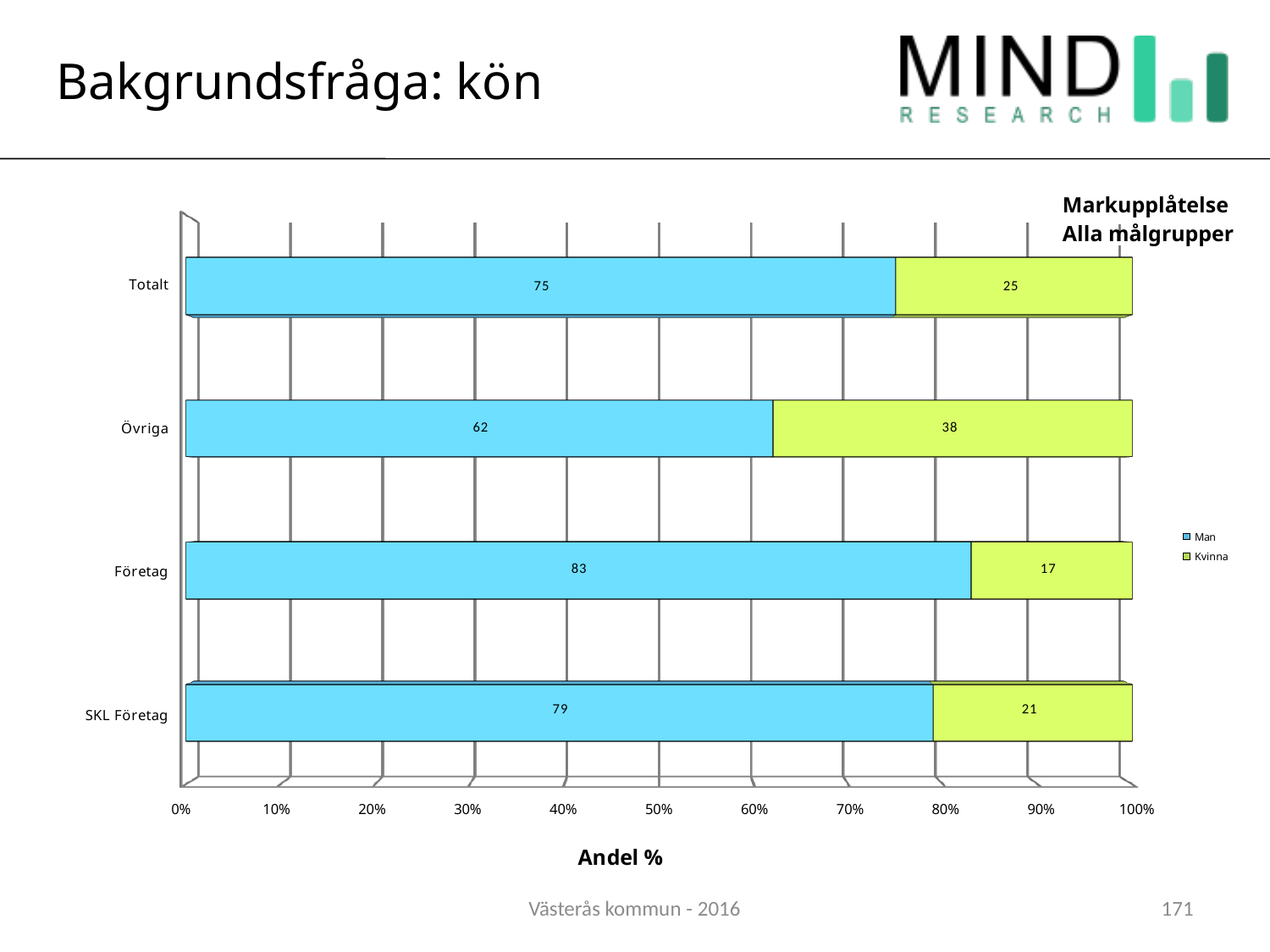
How many categories are shown on the chart? 4 What kind of chart is shown on the slide? Stacked bar chart How many series does the legend list? 2 What is the value for Kvinna in the Övriga category? 38 Is the Man value for SKL Företag larger than the Man value for Totalt? Yes What is the value for Kvinna in the SKL Företag category? 21 Which category has the highest value for Man? Företag What is the label of the x axis? Andel % What is the difference between the Man and Kvinna values in the Övriga category? 24 What is the value for Man in the Totalt category? 75 Which category has the lowest value for Kvinna? Företag What is the value for Man in the Företag category? 83